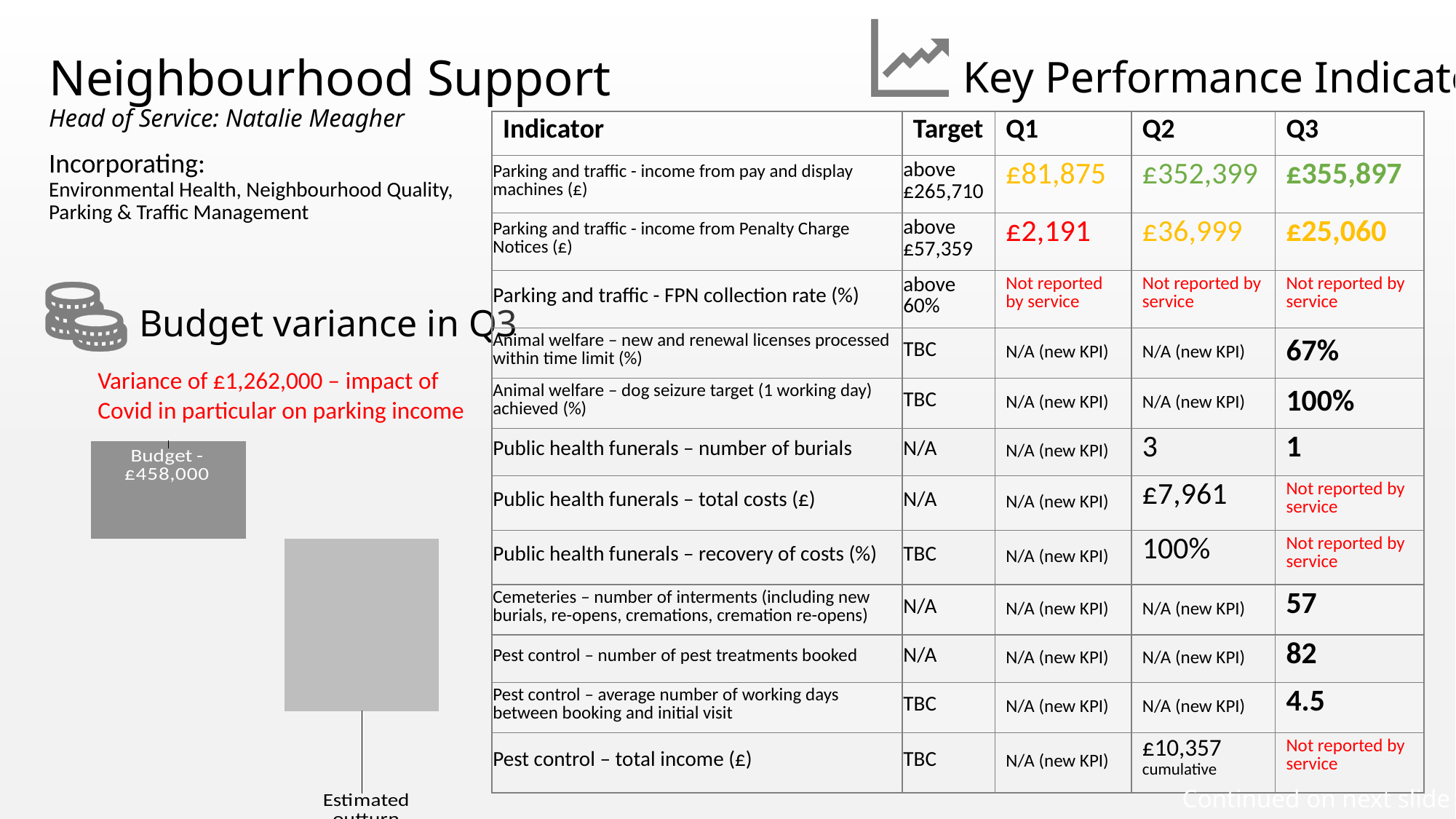
In the 'Budget variance in Q3' chart, is the value for Budget greater or less than 0? greater What is the title of the chart on the left of the slide? Budget variance in Q3 What kind of chart is shown under the heading 'Budget variance in Q3'? bar chart In the 'Budget variance in Q3' chart, which bar extends below the axis, Budget or Estimated outturn? Estimated outturn How many bars does the 'Budget variance in Q3' chart show? 2 In the 'Budget variance in Q3' chart, what value is printed on the Budget bar? £458,000